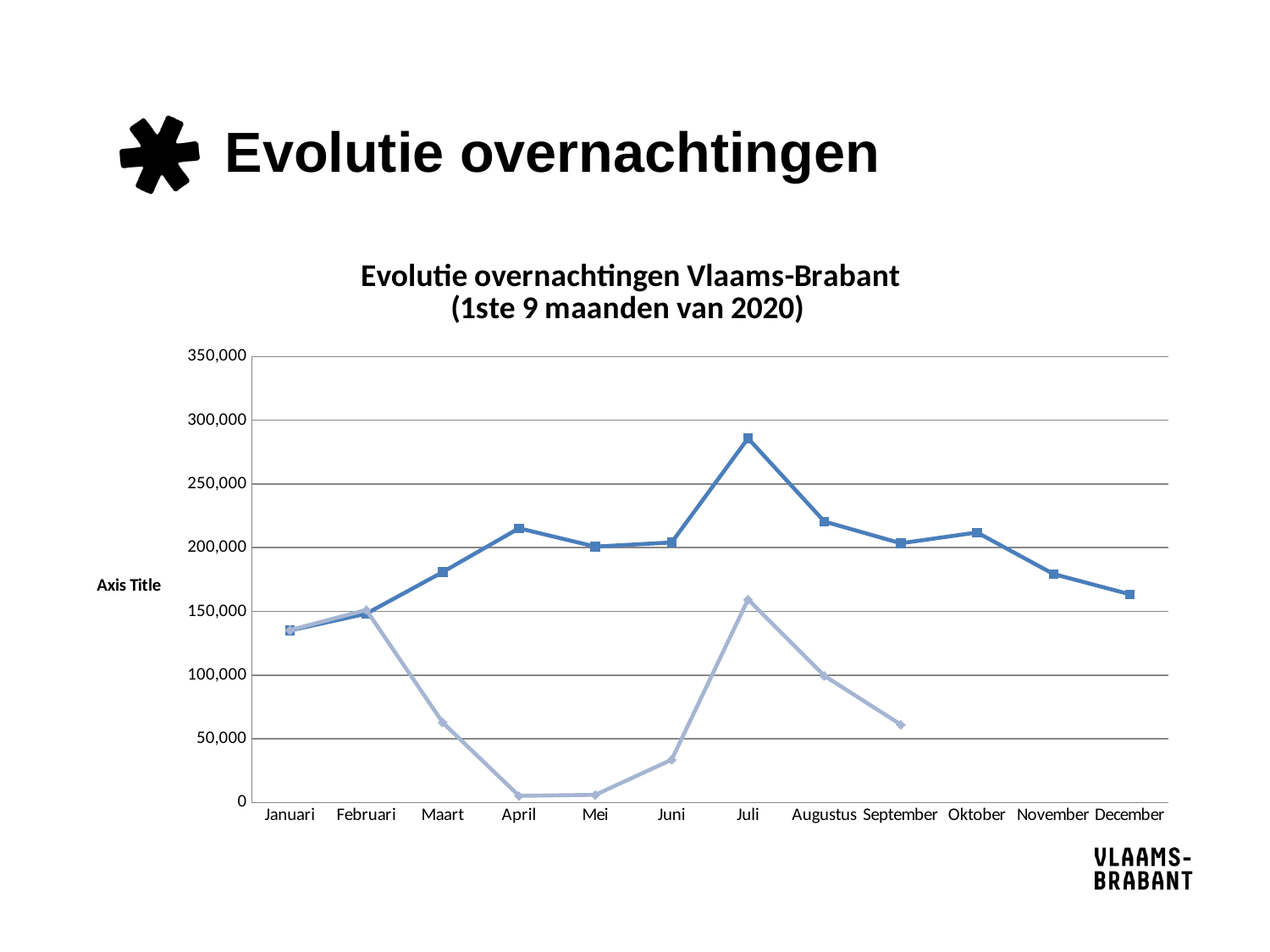
In which month does the dark blue line have its lowest value? Januari Does the dark blue line rise or fall from Juli to December? fall What is the title of the chart? Evolutie overnachtingen Vlaams-Brabant (1ste 9 maanden van 2020) What kind of chart is shown on the slide? line chart In which month does the dark blue line reach its highest value? Juli What label is shown on the vertical axis of the chart? Axis Title Which is larger on the light blue line: the value for Februari or the value for Maart? Februari Is the value of the dark blue line for April greater or less than 200,000? greater Is the value of the dark blue line for Juli greater or less than 250,000? greater How many lines are plotted on the chart? 2 How many months are listed along the x axis of the chart? 12 Is the value of the light blue line for April greater or less than 50,000? less